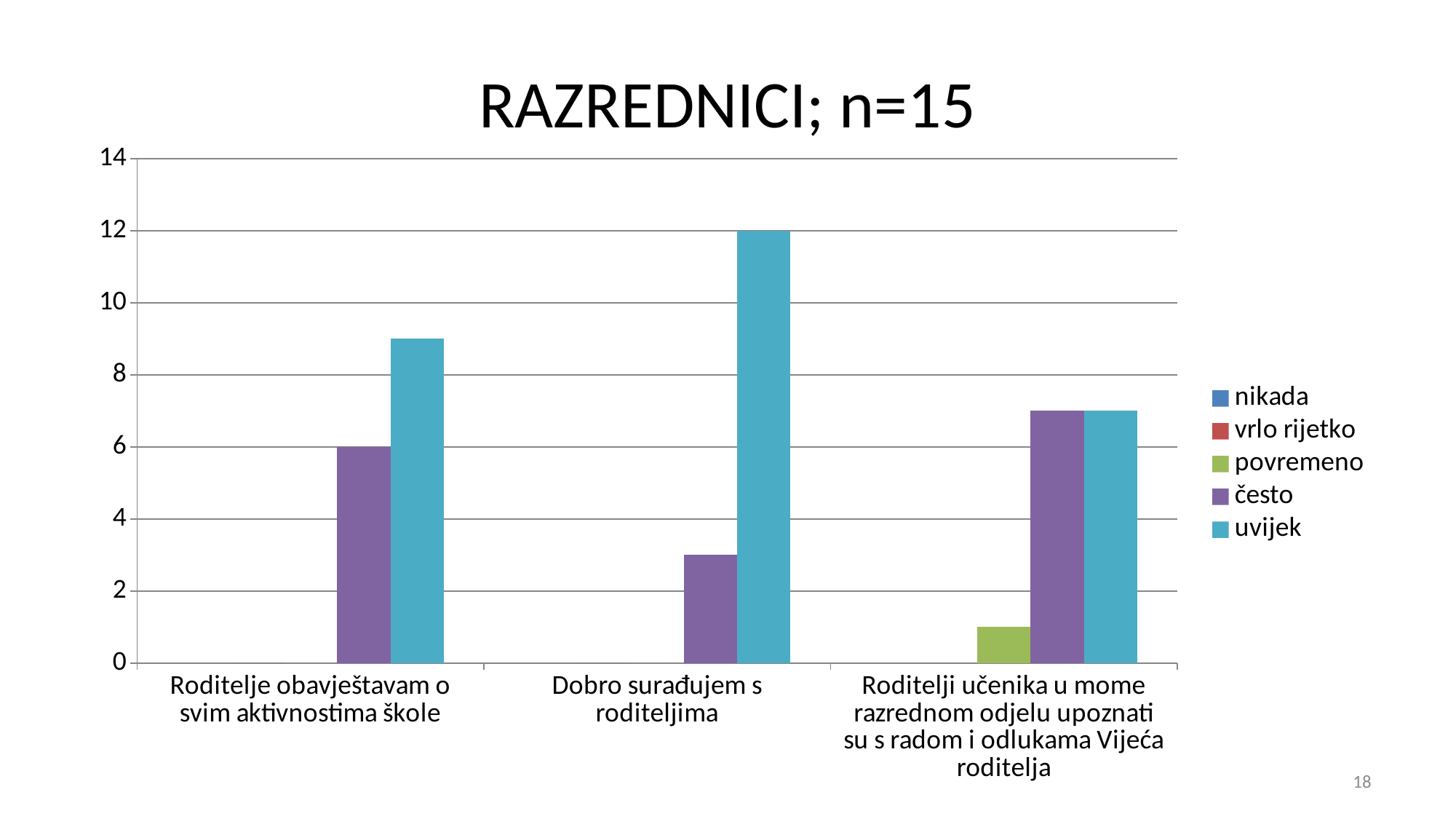
For "Roditelje obavještavam o svim aktivnostima škole", which is larger: "često" or "uvijek"? uvijek For which category is the "uvijek" bar the highest? Dobro surađujem s roditeljima What is the value of "često" for "Roditelje obavještavam o svim aktivnostima škole"? 6 How many categories are shown on the x axis? 3 Is the value of "povremeno" for "Roditelji učenika u mome razrednom odjelu upoznati su s radom i odlukama Vijeća roditelja" greater or less than 2? less What is the title of the chart? RAZREDNICI; n=15 Is the value of "uvijek" for "Roditelje obavještavam o svim aktivnostima škole" greater or less than 8? greater For which category is the "često" bar the lowest? Dobro surađujem s roditeljima Is the value of "često" for "Dobro surađujem s roditeljima" greater or less than 4? less How many series does the legend list? 5 What is the value of "uvijek" for "Dobro surađujem s roditeljima"? 12 What kind of chart is shown on the slide? bar chart